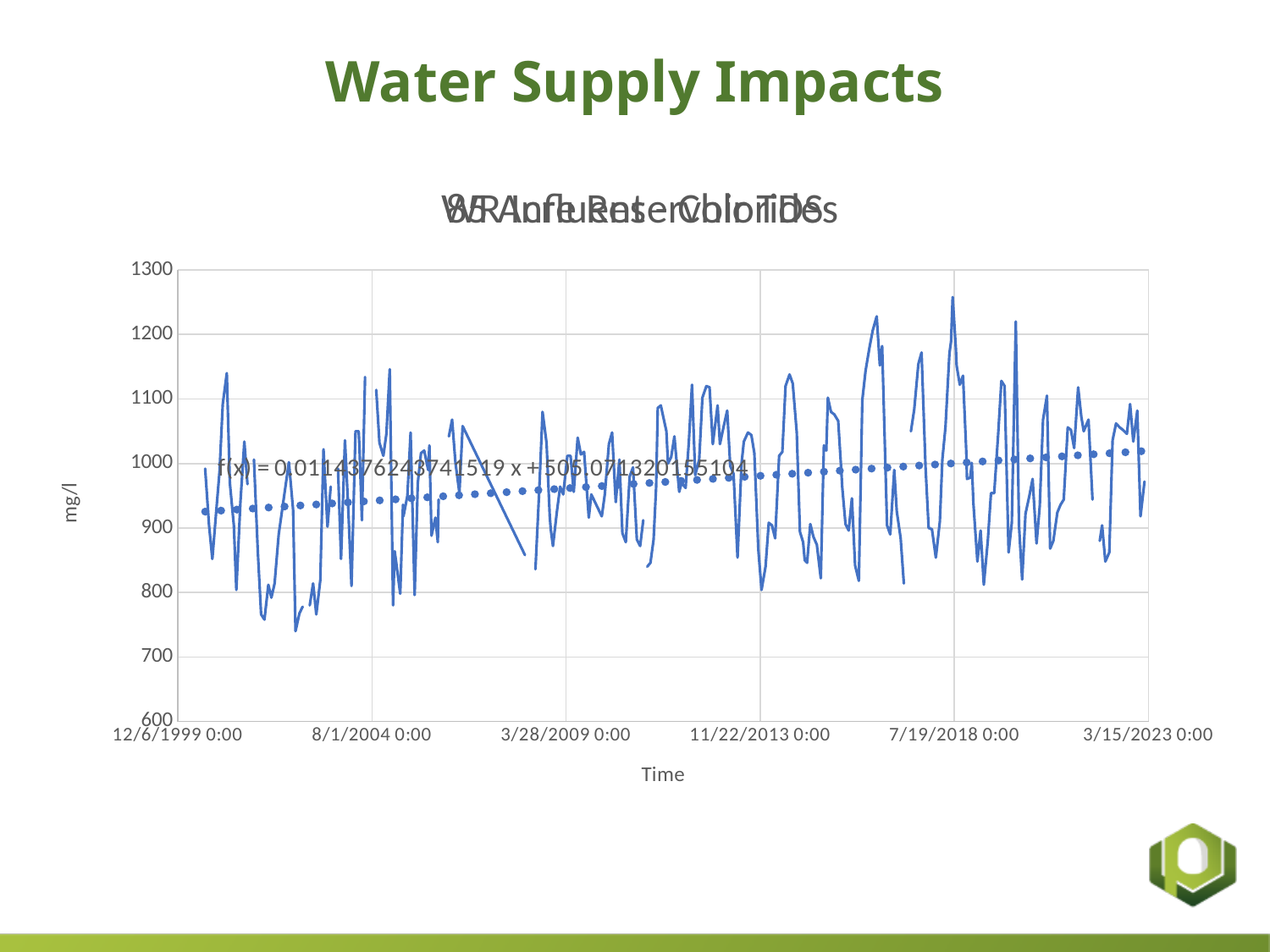
Does the dotted trendline rise or fall from left to right across the chart? rises What is the label on the vertical axis of the chart? mg/l Is the highest peak of the plotted line greater or less than 1200 mg/l? greater What is the label on the horizontal axis of the chart? Time Is the dotted trendline value at the left edge of the chart (12/6/1999) greater or less than 1000 mg/l? less What is the highest value shown on the vertical axis? 1300 What kind of chart is shown on the slide? line chart Is the dotted trendline value at the right edge of the chart (near 3/15/2023) greater or less than 900 mg/l? greater How many date labels are shown along the horizontal axis? 6